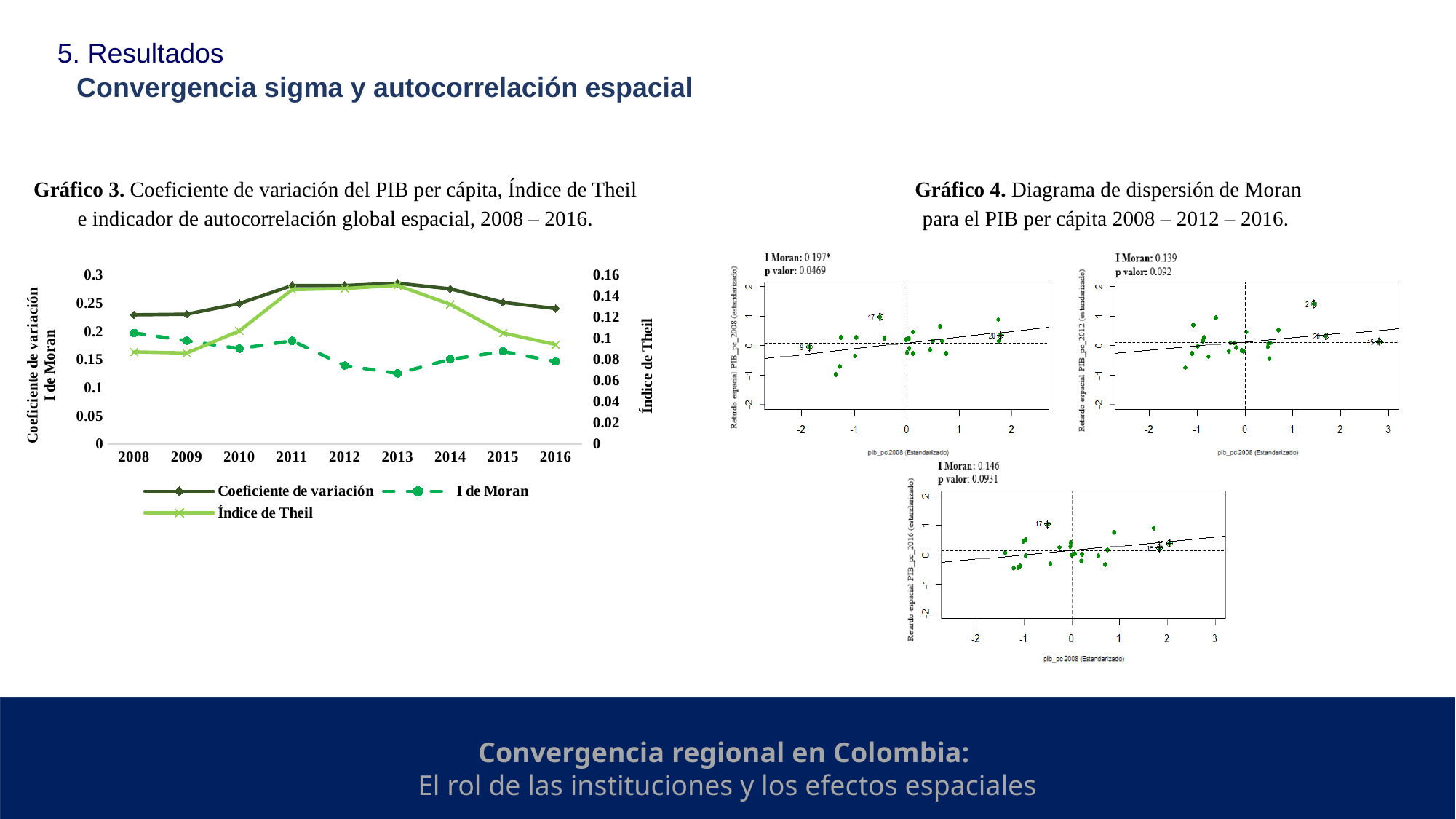
In Gráfico 4, what is the p valor shown for the 2016 scatter plot (bottom)? 0.0931 What type of chart is Gráfico 3? Line chart In Gráfico 3, does the Coeficiente de variación rise or fall from 2013 to 2016? fall In Gráfico 3, in which year is the I de Moran series at its lowest? 2013 In Gráfico 3, which axis (left or right) is the Índice de Theil plotted against? Right In Gráfico 4, what is the I Moran value shown for the 2008 scatter plot (top left)? 0.197* How many series does the legend of Gráfico 3 list? 3 In Gráfico 3, is the Coeficiente de variación for 2008 greater or less than 0.25? less In Gráfico 3, is the Coeficiente de variación for 2013 greater or less than 0.25? greater In Gráfico 3, is the I de Moran value for 2013 greater or less than 0.15? less How many years are shown on the x axis of Gráfico 3? 9 In Gráfico 3, which is larger: the Coeficiente de variación in 2011 or in 2008? 2011